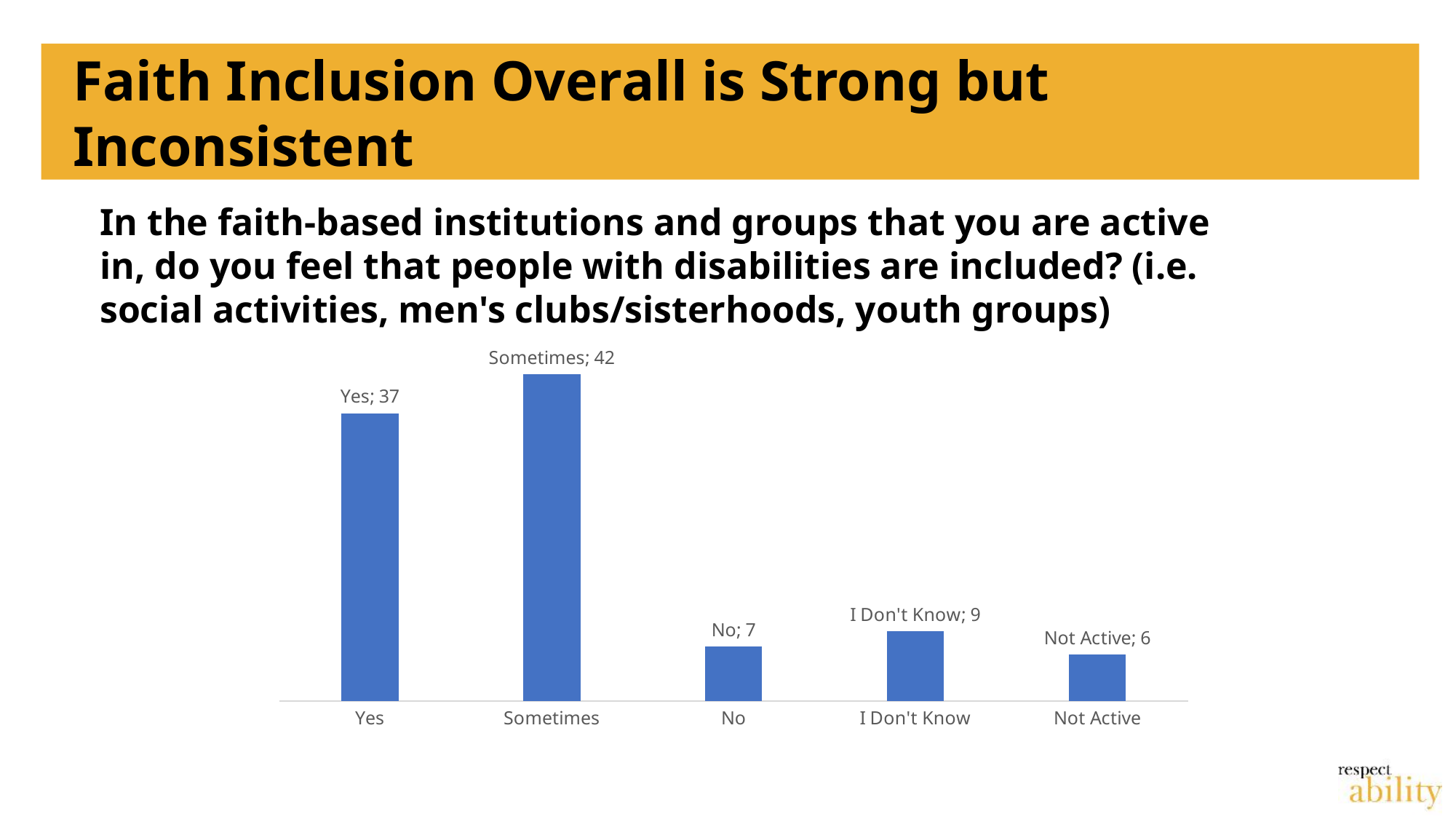
What kind of chart is shown on the slide? Bar chart What is the value for Yes? 37 Which category has the lowest value? Not Active What is the value for Not Active? 6 What is the value for No? 7 Which category has the highest value? Sometimes What is the value for I Don't Know? 9 How many categories are shown on the x axis? 5 What is the total of the values for No, I Don't Know and Not Active? 22 Which is larger, the value for No or the value for I Don't Know? I Don't Know What is the difference between the values for Sometimes and Yes? 5 What is the value for Sometimes? 42